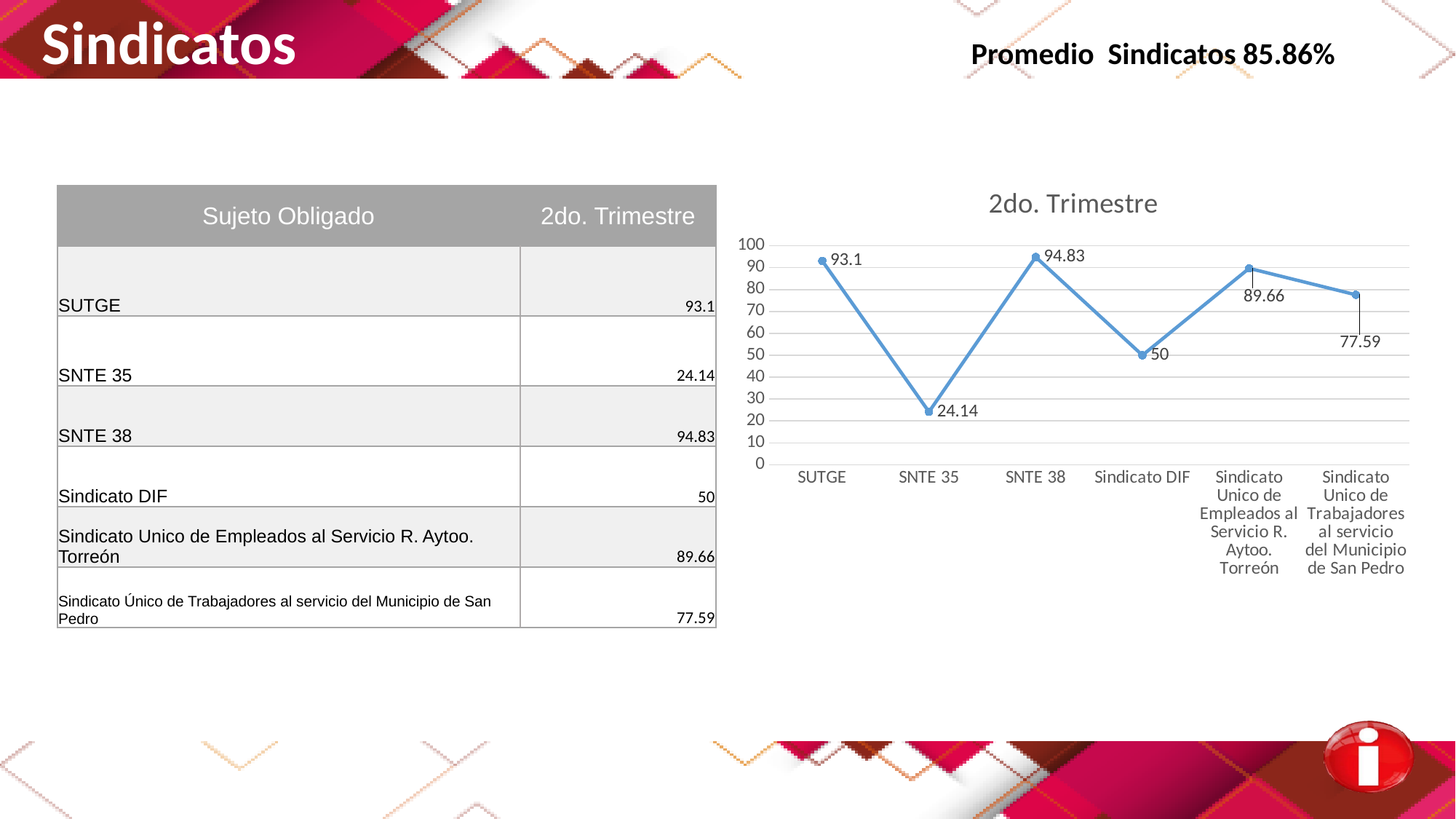
Does the value rise or fall from SUTGE to SNTE 35? fall What is the value for Sindicato DIF in the chart? 50 What is the value for SUTGE in the chart? 93.1 What is the difference between the values for SNTE 38 and SNTE 35? 70.69 Which category has the lowest value in the chart? SNTE 35 Which is larger, the value for SUTGE or the value for Sindicato Unico de Empleados al Servicio R. Aytoo. Torreón? SUTGE What is the value for SNTE 38 in the chart? 94.83 What is the title of the chart? 2do. Trimestre Is the value for Sindicato Unico de Trabajadores al servicio del Municipio de San Pedro greater or less than 80? less Which category has the highest value in the chart? SNTE 38 How many categories are plotted in the chart? 6 What kind of chart is shown on the slide? line chart